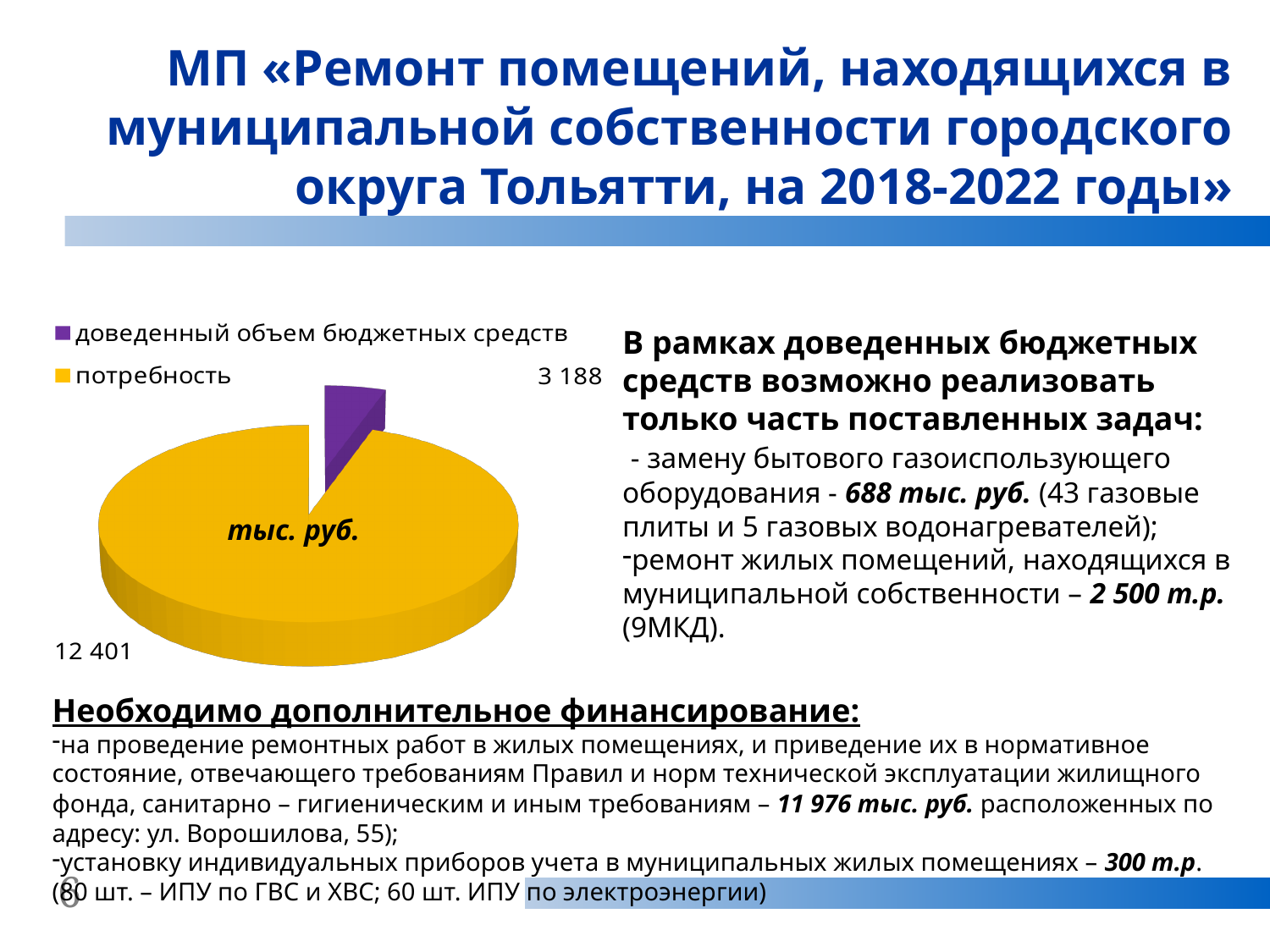
What is the value for «доведенный объем бюджетных средств» in the pie chart? 3 188 How many entries does the legend of the pie chart list? 2 What unit label is printed inside the pie chart? тыс. руб. What is the value for «потребность» in the pie chart? 12 401 What is the total of the two values shown in the pie chart? 15 589 What is the difference between «потребность» and «доведенный объем бюджетных средств» in the pie chart? 9 213 How many slices does the pie chart have? 2 Which slice of the pie chart is the smallest? доведенный объем бюджетных средств Which is larger in the pie chart: «потребность» or «доведенный объем бюджетных средств»? потребность What colour is the «потребность» slice in the pie chart? yellow What kind of chart is shown on the slide? pie chart Which slice of the pie chart is the largest? потребность